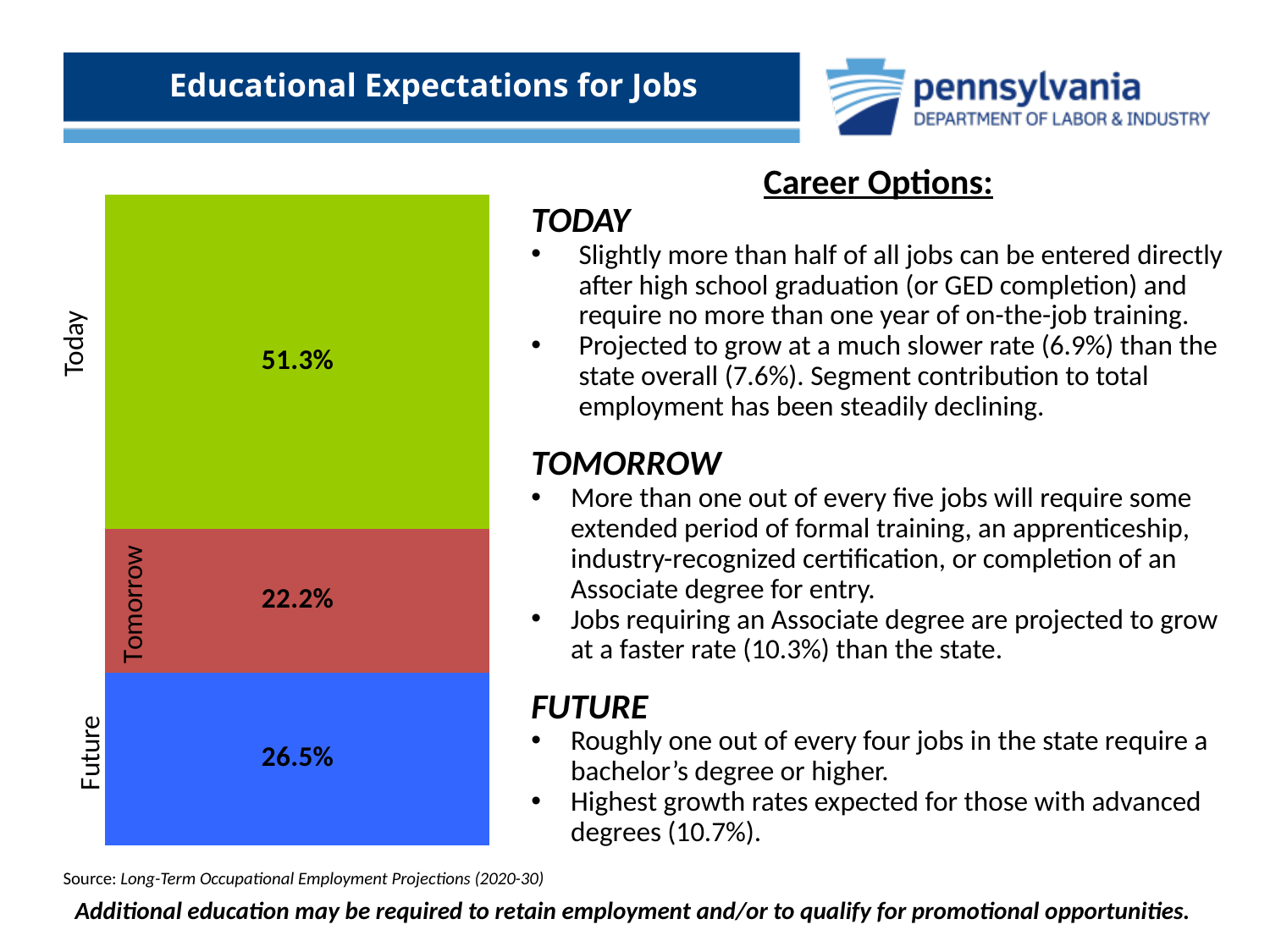
What is the difference between the Future and Tomorrow percentages? 4.3% What percentage is shown for the Tomorrow segment of the stacked bar? 22.2% Which segment of the stacked bar has the smallest value? Tomorrow What percentage is shown for the Future segment of the stacked bar? 26.5% What is the difference between the Today and Future percentages? 24.8% What percentage is shown for the Today segment of the stacked bar? 51.3% What colour is the Today segment of the stacked bar? Green Which is larger, the Future segment or the Tomorrow segment? Future How many segments make up the stacked bar? 3 What is the total of the three segments in the stacked bar? 100.0% Which segment of the stacked bar has the largest value? Today What type of chart is shown on the slide? Stacked bar chart